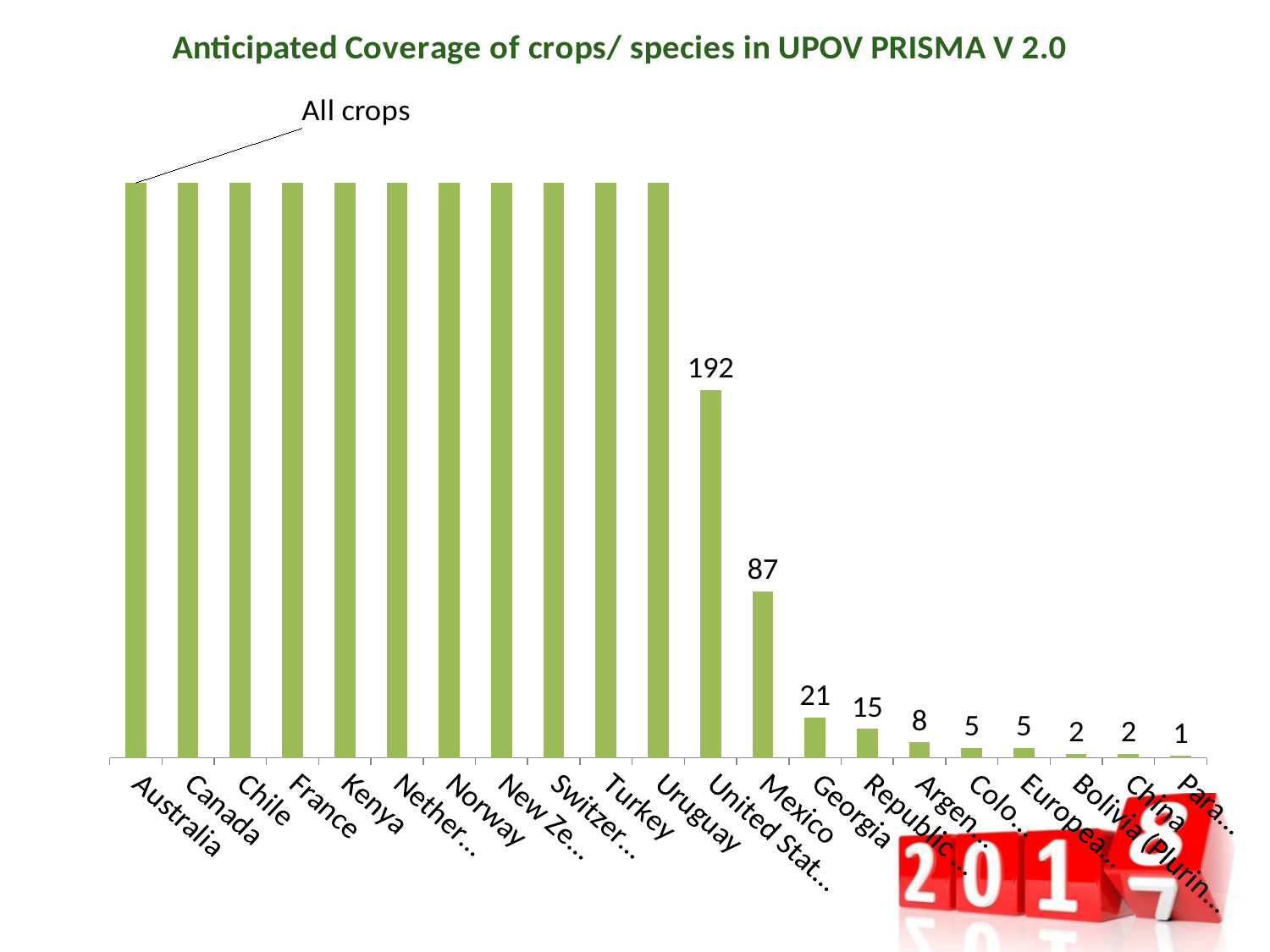
What is the difference between the value for "United Stat…" and the value for Mexico? 105 Which has the larger value, Mexico or Georgia? Mexico What value is shown for China? 2 Which of Georgia, Mexico and China has the lowest value? China How many categories (bars) are shown in the chart? 21 What kind of chart is shown on the slide? Bar chart What value is shown for Mexico? 87 What is the difference between the value for Georgia and the value for China? 19 What value is shown for Georgia? 21 What value is shown for the bar labelled "United Stat…"? 192 What annotation is attached to the tallest bars in the chart? All crops Do the bar values rise or fall moving from left to right along the x axis? Fall